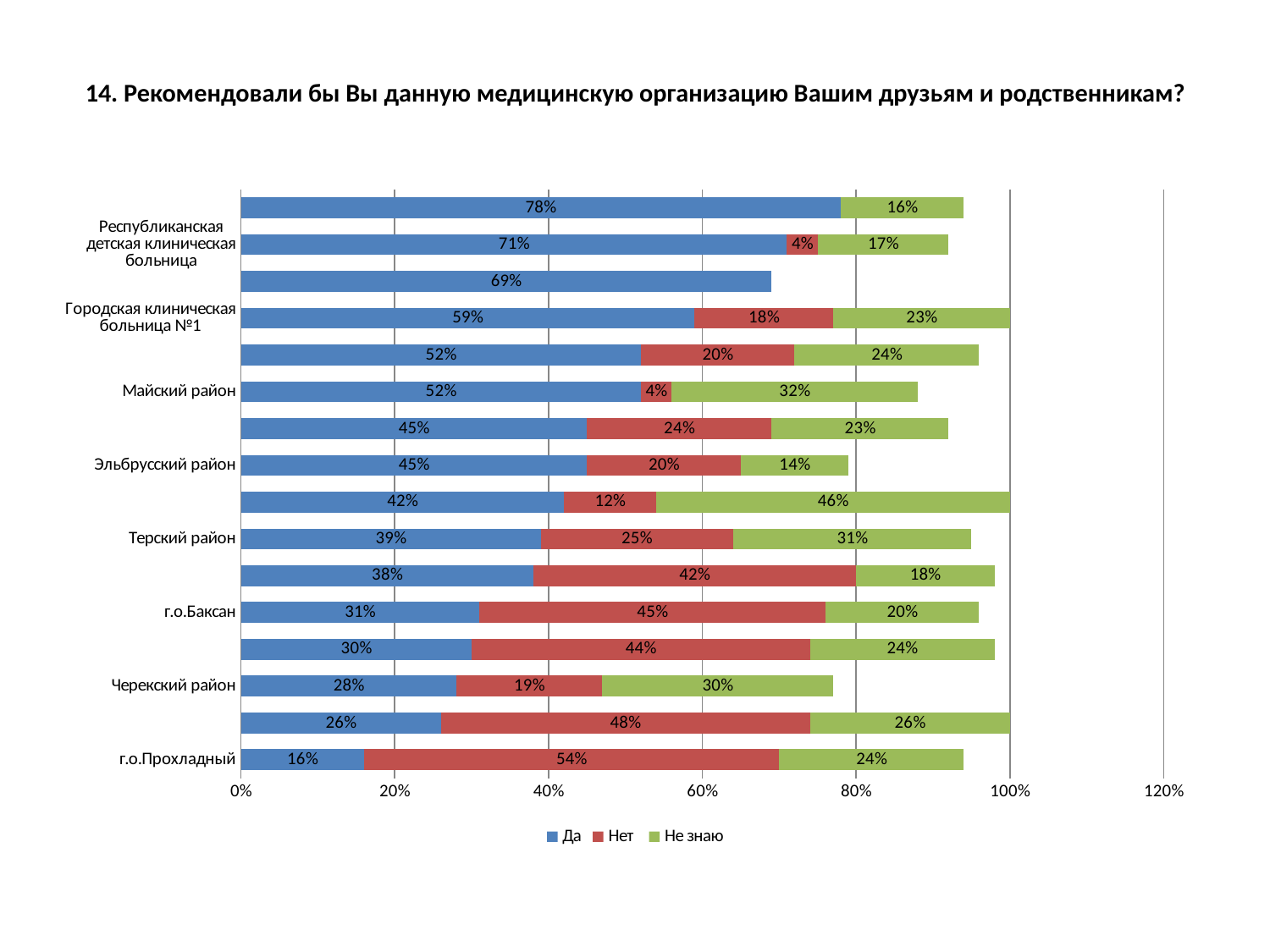
What is the total of the three segments in the bar for Терский район? 95% For г.о.Прохладный, how much larger is the "Нет" share than the "Да" share? 38 percentage points What is the "Нет" value for г.о.Баксан? 45% What is the total of the three segments in the bar for Эльбрусский район? 79% What is the "Да" value for Эльбрусский район? 45% How many series does the legend list? 3 Which has a larger "Не знаю" share: Черекский район or Эльбрусский район? Черекский район What share answered "Не знаю" for Майский район? 32% What type of chart is shown on the slide? Stacked bar chart What percentage answered "Да" for г.о.Прохладный? 16% Which has a higher "Да" share: Городская клиническая больница №1 or Майский район? Городская клиническая больница №1 What is the "Нет" value for Черекский район? 19%